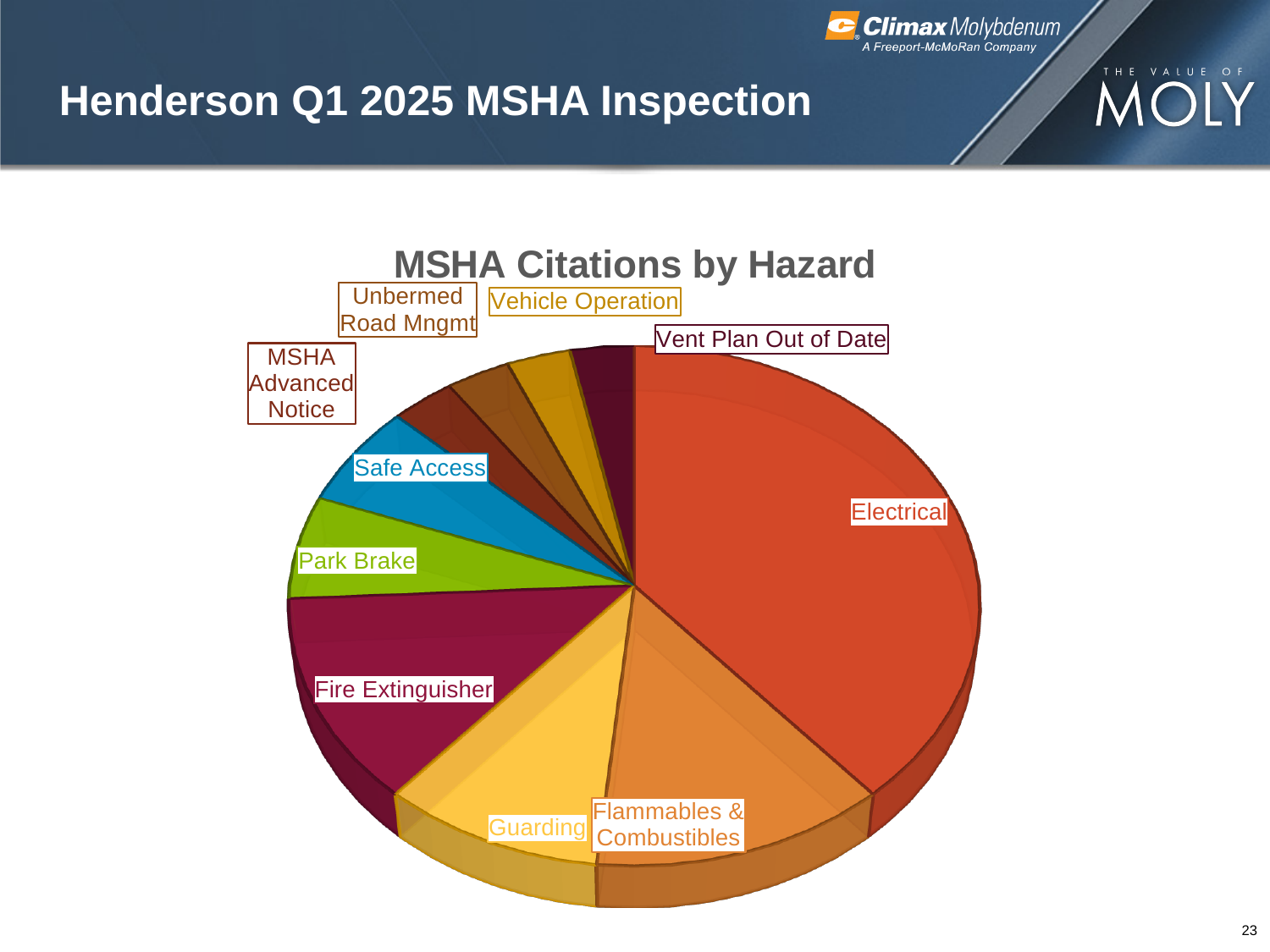
What is the title of the chart? MSHA Citations by Hazard How many hazard categories are shown in the pie chart? 10 Which slice is larger, Electrical or Fire Extinguisher? Electrical Which slice is larger, Flammables & Combustibles or Park Brake? Flammables & Combustibles Which slice is larger, Electrical or Guarding? Electrical What kind of chart is shown on the slide? pie chart Which hazard category is shown in the blue slice of the pie? Safe Access Which hazard category has the largest slice of the pie? Electrical